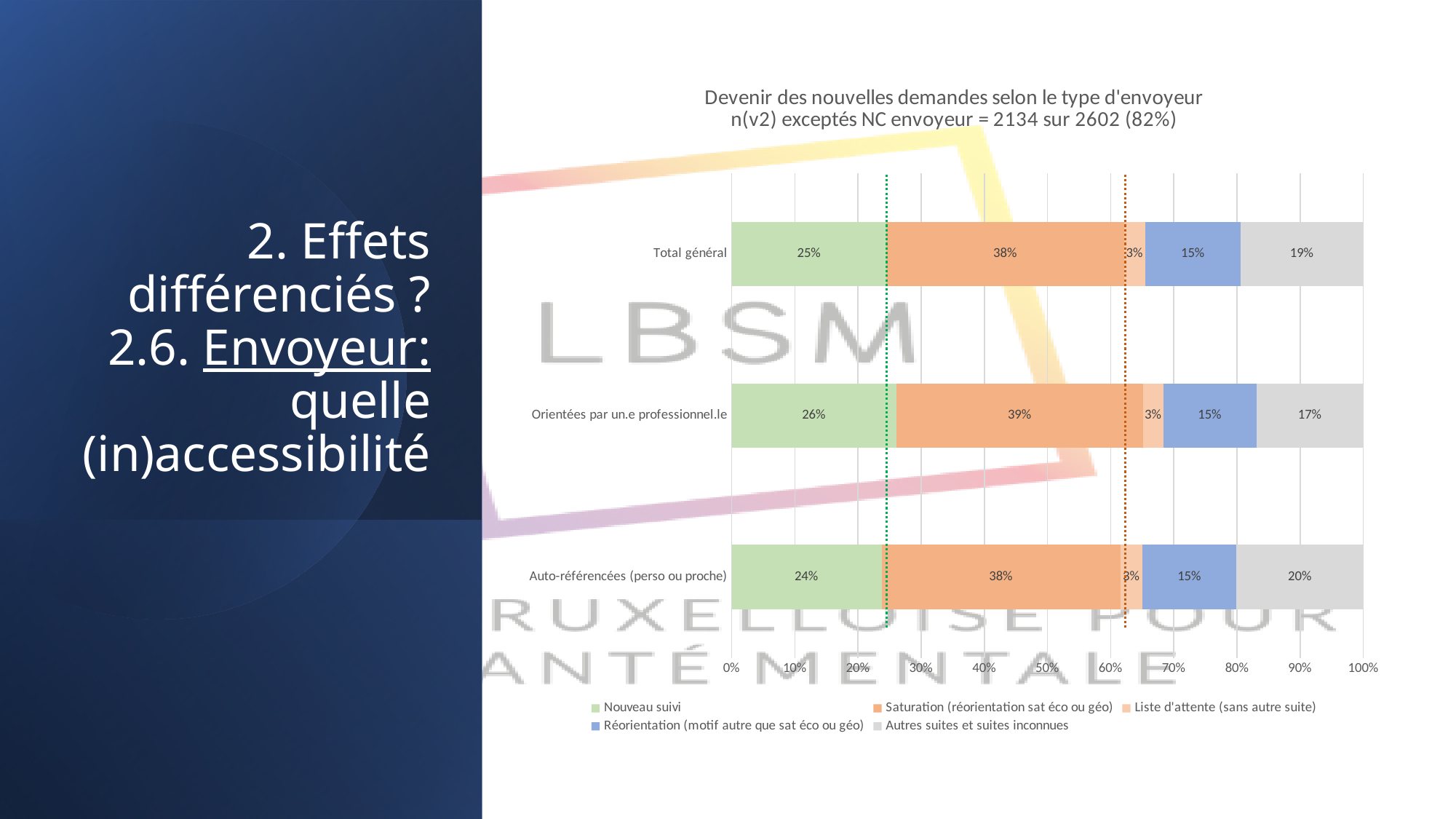
How many categories (bars) does the chart show? 3 Which category has the highest value for 'Nouveau suivi'? Orientées par un.e professionnel.le What is the value of 'Réorientation (motif autre que sat éco ou géo)' for 'Total général'? 15% What is the difference between the 'Autres suites et suites inconnues' values for 'Auto-référencées (perso ou proche)' and 'Orientées par un.e professionnel.le'? 3% What is the value of 'Autres suites et suites inconnues' for 'Auto-référencées (perso ou proche)'? 20% What is the value of 'Nouveau suivi' for 'Orientées par un.e professionnel.le'? 26% Which category has the lowest value for 'Autres suites et suites inconnues'? Orientées par un.e professionnel.le What is the value of 'Saturation (réorientation sat éco ou géo)' for 'Total général'? 38% What kind of chart is shown on the slide? stacked bar chart How many series does the legend list? 5 What is the title of the chart? Devenir des nouvelles demandes selon le type d'envoyeur n(v2) exceptés NC envoyeur = 2134 sur 2602 (82%) Which is larger: the 'Saturation (réorientation sat éco ou géo)' value for 'Orientées par un.e professionnel.le' or for 'Auto-référencées (perso ou proche)'? Orientées par un.e professionnel.le